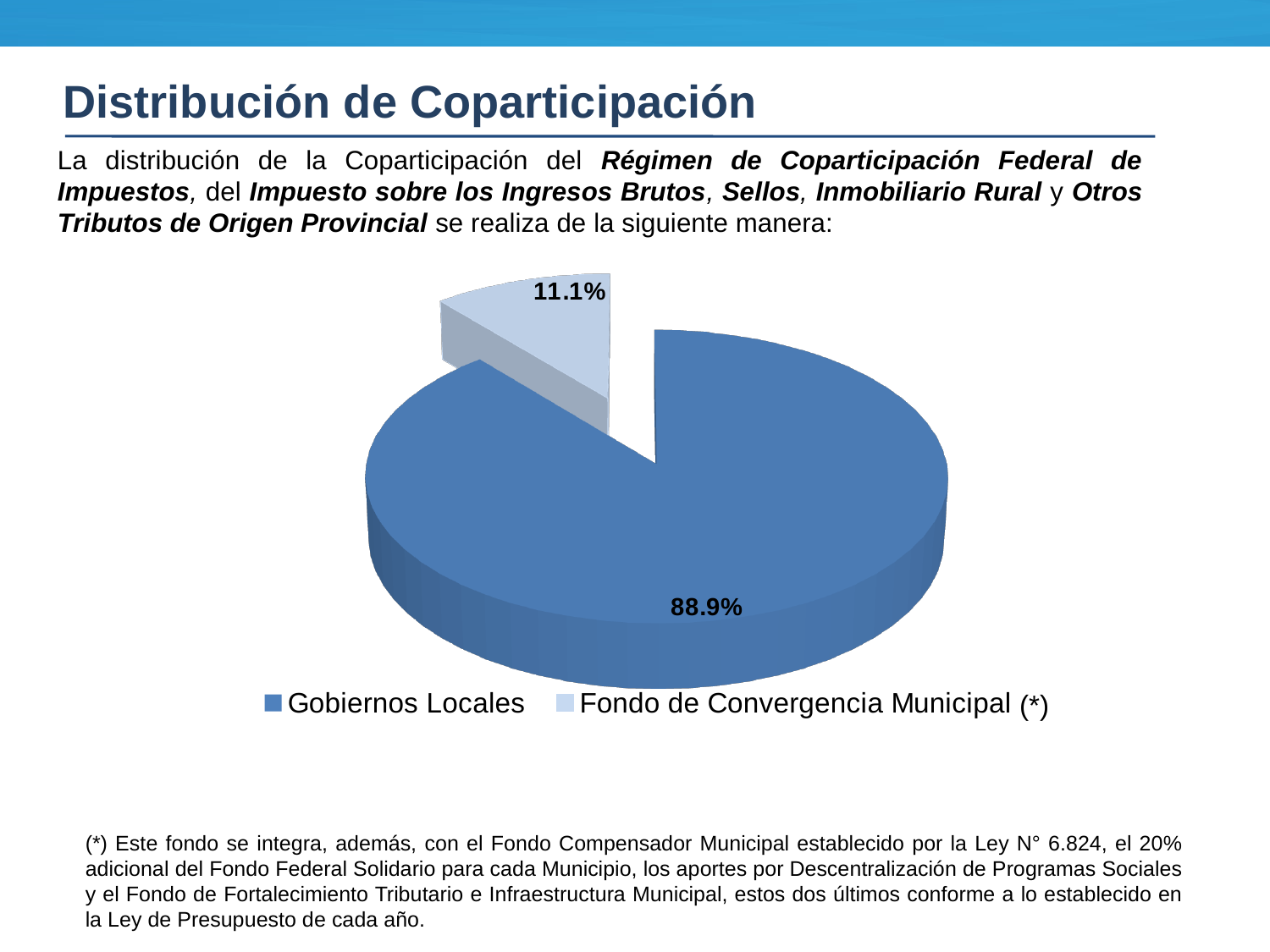
Which is larger, the share for Gobiernos Locales or the share for Fondo de Convergencia Municipal (*)? Gobiernos Locales What kind of chart is shown on the slide? Pie chart What is the title of the slide containing the pie chart? Distribución de Coparticipación What is the combined share of the two slices in the pie chart? 100% What is the difference in percentage points between the Gobiernos Locales share and the Fondo de Convergencia Municipal (*) share? 77.8 Which legend entry is shown in the lighter blue colour? Fondo de Convergencia Municipal (*) How many slices does the pie chart have? 2 How many entries does the legend list? 2 What share of the pie does Gobiernos Locales receive? 88.9% Which category has the largest slice of the pie? Gobiernos Locales Which category has the smallest slice of the pie? Fondo de Convergencia Municipal (*) What share of the pie does Fondo de Convergencia Municipal (*) receive? 11.1%